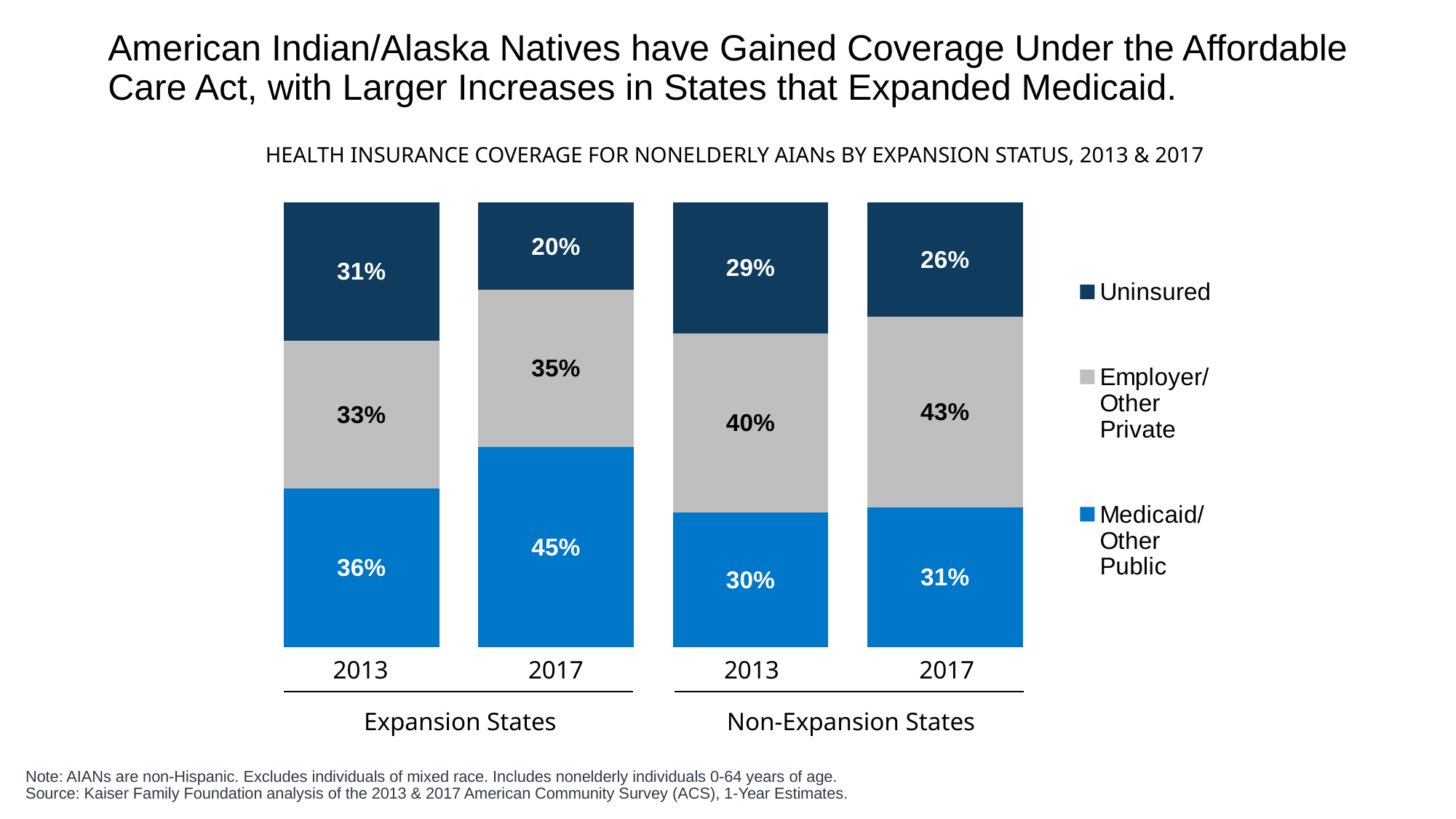
What is the Employer/Other Private share for Non-Expansion States in 2017? 43% By how many percentage points did the Uninsured share in Expansion States fall from 2013 to 2017? 11 percentage points Which is larger: the Employer/Other Private share for Non-Expansion States in 2013 or for Expansion States in 2013? Non-Expansion States in 2013 Which colour represents Uninsured in the legend? Dark blue Which bar has the highest Medicaid/Other Public share? Expansion States 2017 What is the Uninsured share for Expansion States in 2013? 31% What is the Medicaid/Other Public share for Expansion States in 2017? 45% How many series does the legend list? 3 How many bars are shown in the chart? 4 Which bar has the lowest Uninsured share? Expansion States 2017 What kind of chart is shown? Stacked bar chart What is the Uninsured share for Non-Expansion States in 2013? 29%